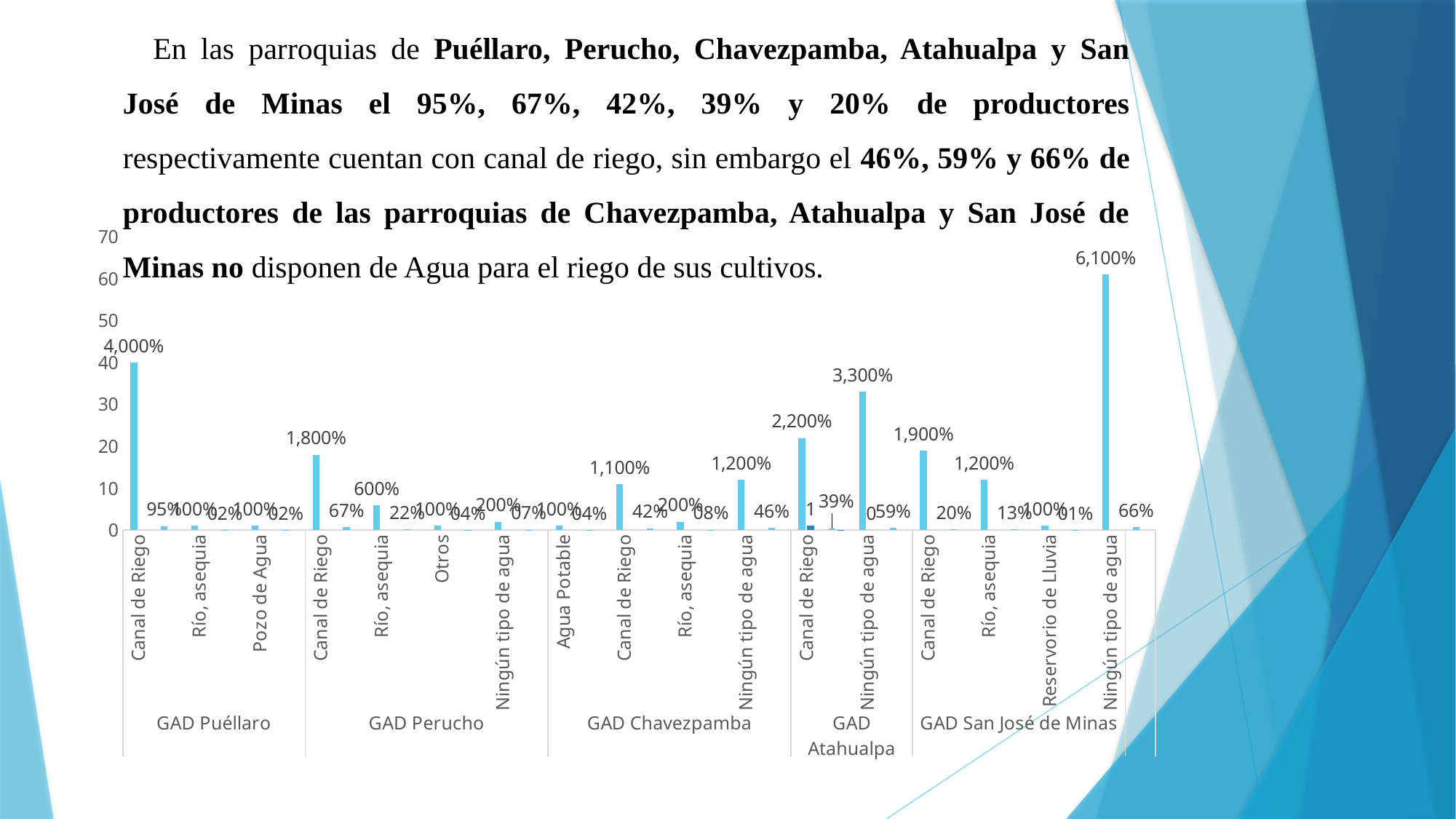
Which bar has the highest labelled value on the chart? Ningún tipo de agua (GAD San José de Minas) Which is larger: the Canal de Riego label for GAD Atahualpa or the Canal de Riego label for GAD San José de Minas? GAD Atahualpa How many GAD groups are shown along the x axis of the chart? 5 What is the data label on the Canal de Riego bar in the GAD Perucho group? 1,800% What is the highest tick value shown on the vertical axis of the chart? 70 What is the data label on the Río, asequia bar in the GAD Perucho group? 600% What is the data label on the Ningún tipo de agua bar in the GAD Atahualpa group? 3,300% Is the Canal de Riego bar in the GAD Puéllaro group greater or less than 30 on the vertical axis? greater What is the data label on the Ningún tipo de agua bar in the GAD San José de Minas group? 6,100% What kind of chart is shown on the slide? bar chart What is the difference between the Ningún tipo de agua labels for GAD San José de Minas (6,100%) and GAD Atahualpa (3,300%)? 2,800% What is the data label on the Canal de Riego bar in the GAD Puéllaro group? 4,000%